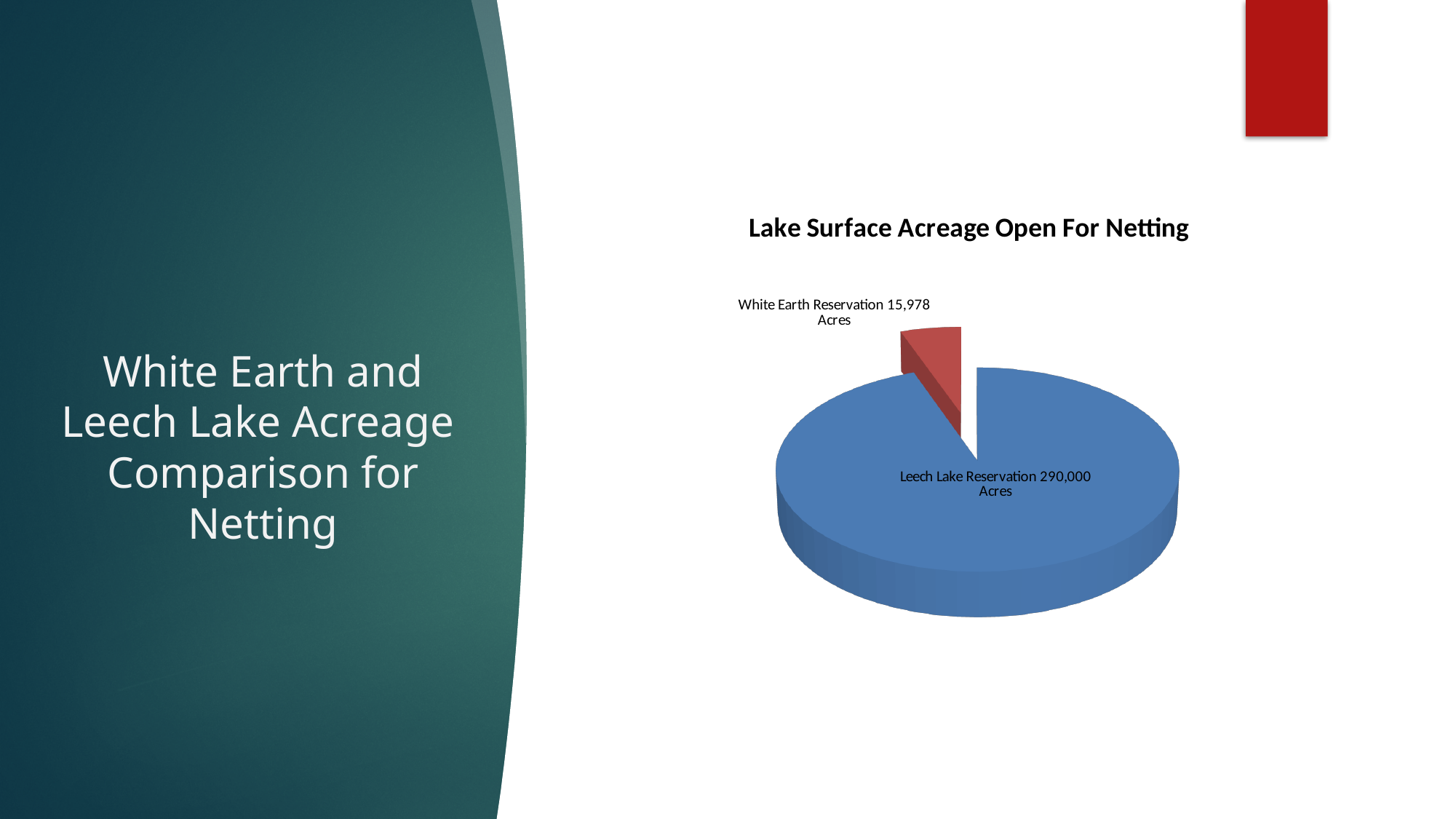
Is the acreage for Leech Lake Reservation larger or smaller than the acreage for White Earth Reservation? larger What is the title of the pie chart? Lake Surface Acreage Open For Netting What is the combined acreage of the two slices in the pie chart? 305,978 How many acres are open for netting on the Leech Lake Reservation according to the chart? 290,000 Acres How many acres are open for netting on the White Earth Reservation according to the chart? 15,978 Acres How many slices does the pie chart have? 2 What colour is the White Earth Reservation slice in the pie chart? red What is the difference in acres between the Leech Lake Reservation and the White Earth Reservation slices? 274,022 Which reservation has the smaller lake surface acreage open for netting? White Earth Reservation Which reservation has the larger lake surface acreage open for netting? Leech Lake Reservation What kind of chart is shown on the slide? pie chart